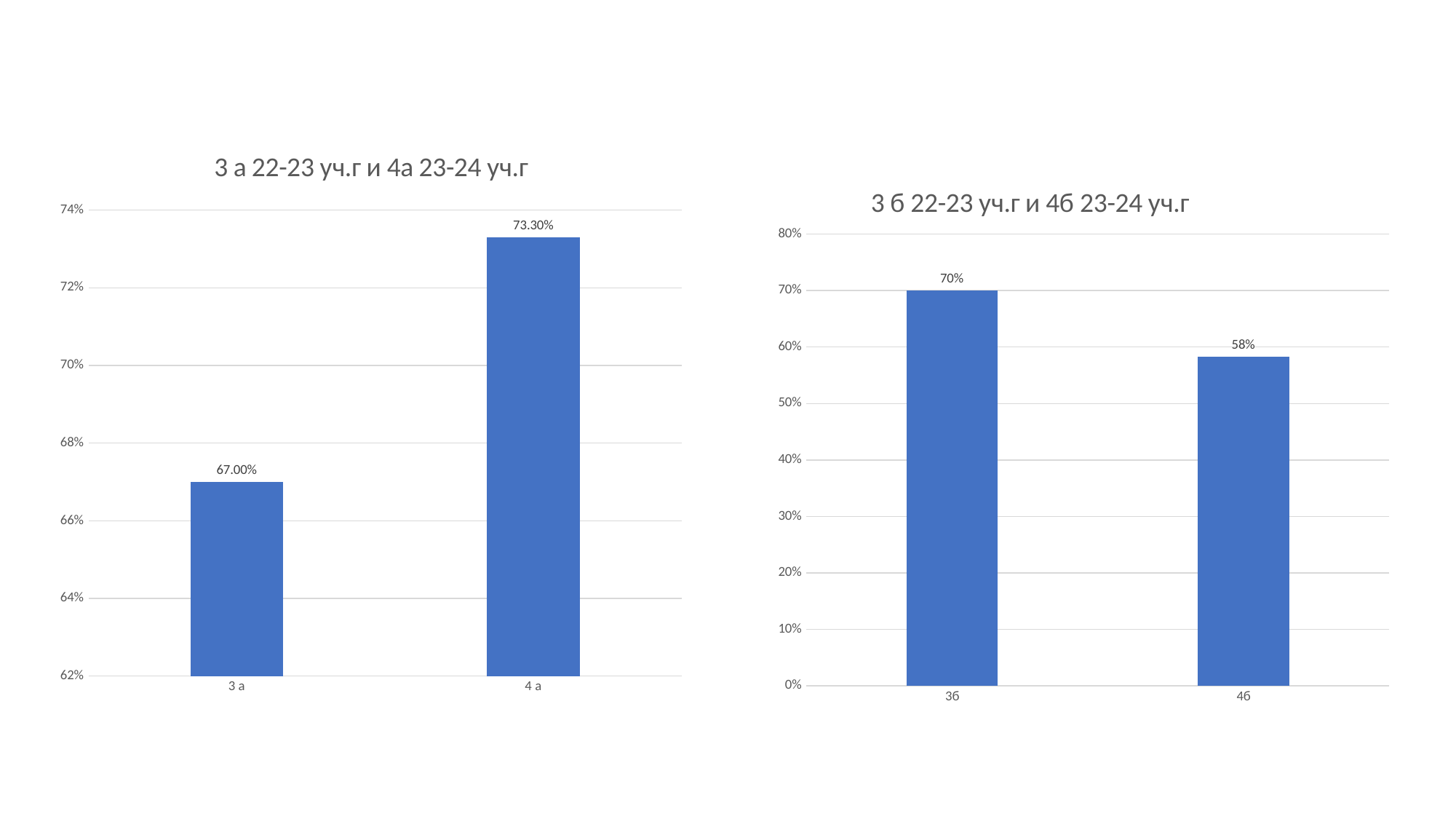
In the left chart, what is the difference between the values for 4 а and 3 а? 6.30% In the left chart, which category has the higher value? 4 а In the right chart titled '3 б 22-23 уч.г и 4б 23-24 уч.г', what is the value for 4б? 58% In the right chart, which category has the lower value? 4б In the left chart titled '3 а 22-23 уч.г и 4а 23-24 уч.г', what is the value for 4 а? 73.30% What type of chart is the right chart? Bar chart In the left chart titled '3 а 22-23 уч.г и 4а 23-24 уч.г', what is the value for 3 а? 67.00% In the right chart titled '3 б 22-23 уч.г и 4б 23-24 уч.г', what is the value for 3б? 70% In the right chart, do the values rise or fall from 3б to 4б? Fall How many bars are in the left chart? 2 In the right chart, what is the difference between the values for 3б and 4б? 12% In the right chart, is the value for 3б greater or less than 60%? greater